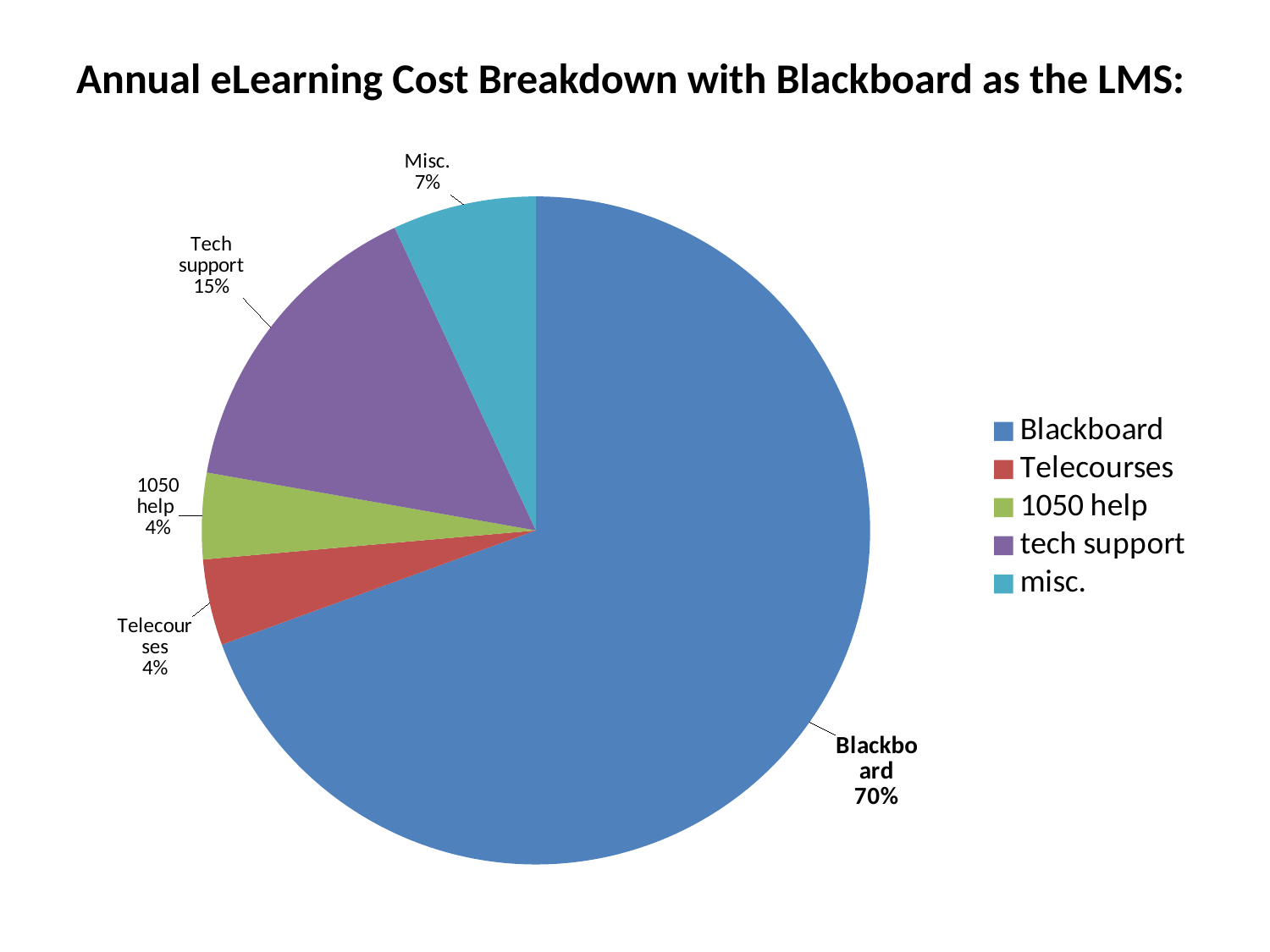
What kind of chart is shown on the slide? Pie chart What percentage of the cost is Misc.? 7% What share of the annual eLearning cost does Blackboard account for? 70% Which is larger, the share for Misc. or the share for Telecourses? Misc. What percentage of the cost is tech support? 15% Which category has the second-largest share of the pie? Tech support What is the difference in percentage points between Blackboard and tech support? 55 Which category has the largest share of the pie? Blackboard What is the difference in percentage points between tech support and Misc.? 8 What is the title of the chart? Annual eLearning Cost Breakdown with Blackboard as the LMS: How many categories does the pie chart show? 5 What percentage of the cost is 1050 help? 4%